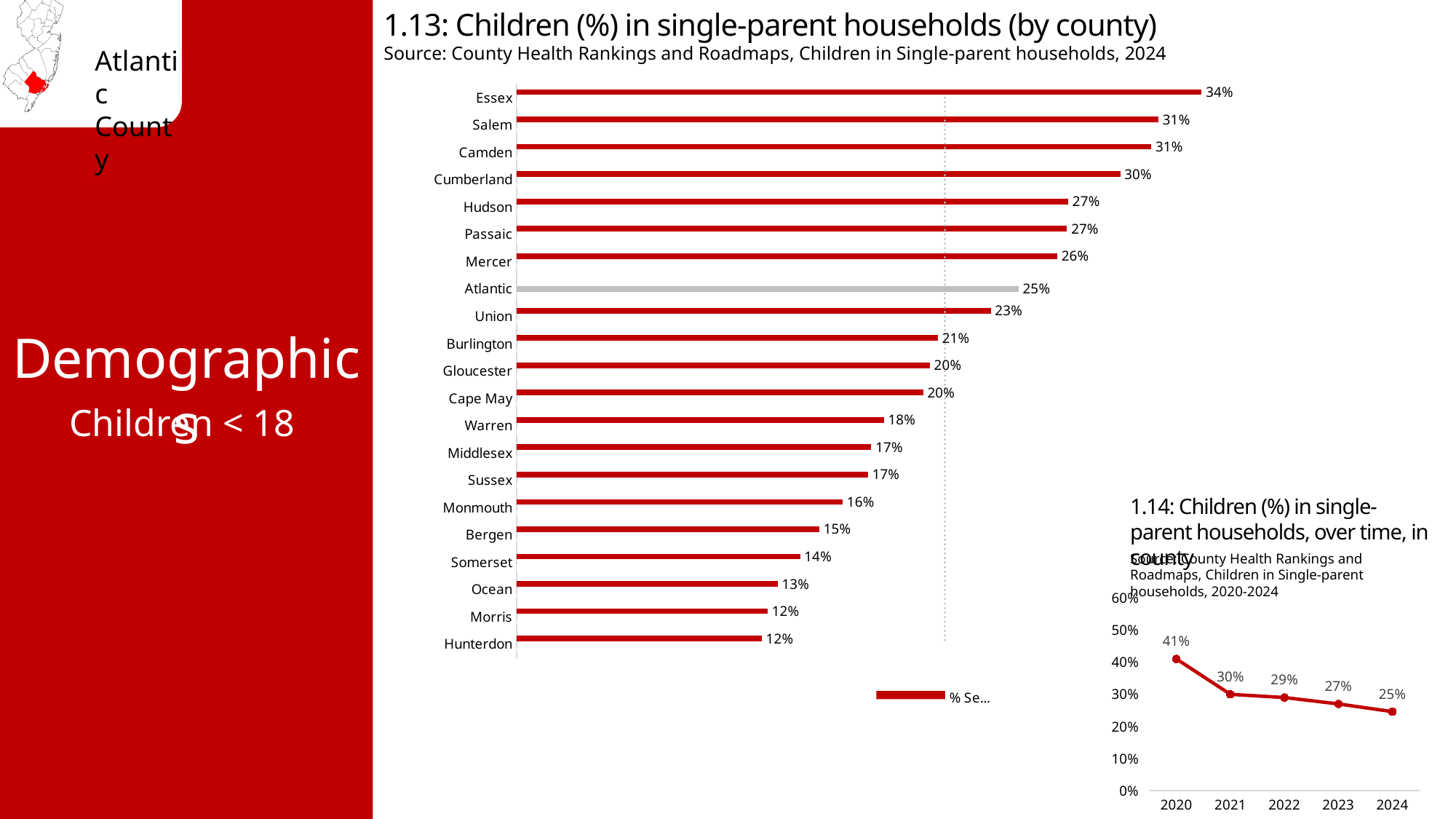
In chart 1.13 (by county), which is larger, the value for Hudson or the value for Union? Hudson In chart 1.13 (by county), how many counties are shown? 21 In chart 1.13 (by county), which county has the highest percentage of children in single-parent households? Essex In chart 1.14 (over time), what is the difference between the values for 2020 and 2021? 11% What kind of chart is chart 1.13 (Children (%) in single-parent households by county)? Bar chart In chart 1.13 (by county), what is the value for Cumberland? 30% In chart 1.14 (over time), do the values rise or fall from 2020 to 2024? Fall In chart 1.13 (by county), which county's bar is coloured grey instead of red? Atlantic In chart 1.13 (by county), what is the difference between the values for Essex and Atlantic? 9% In chart 1.13 (Children (%) in single-parent households by county), what is the value for Atlantic? 25% In chart 1.14 (over time), which year has the lowest value? 2024 In chart 1.14 (Children (%) in single-parent households over time), what is the value for 2020? 41%